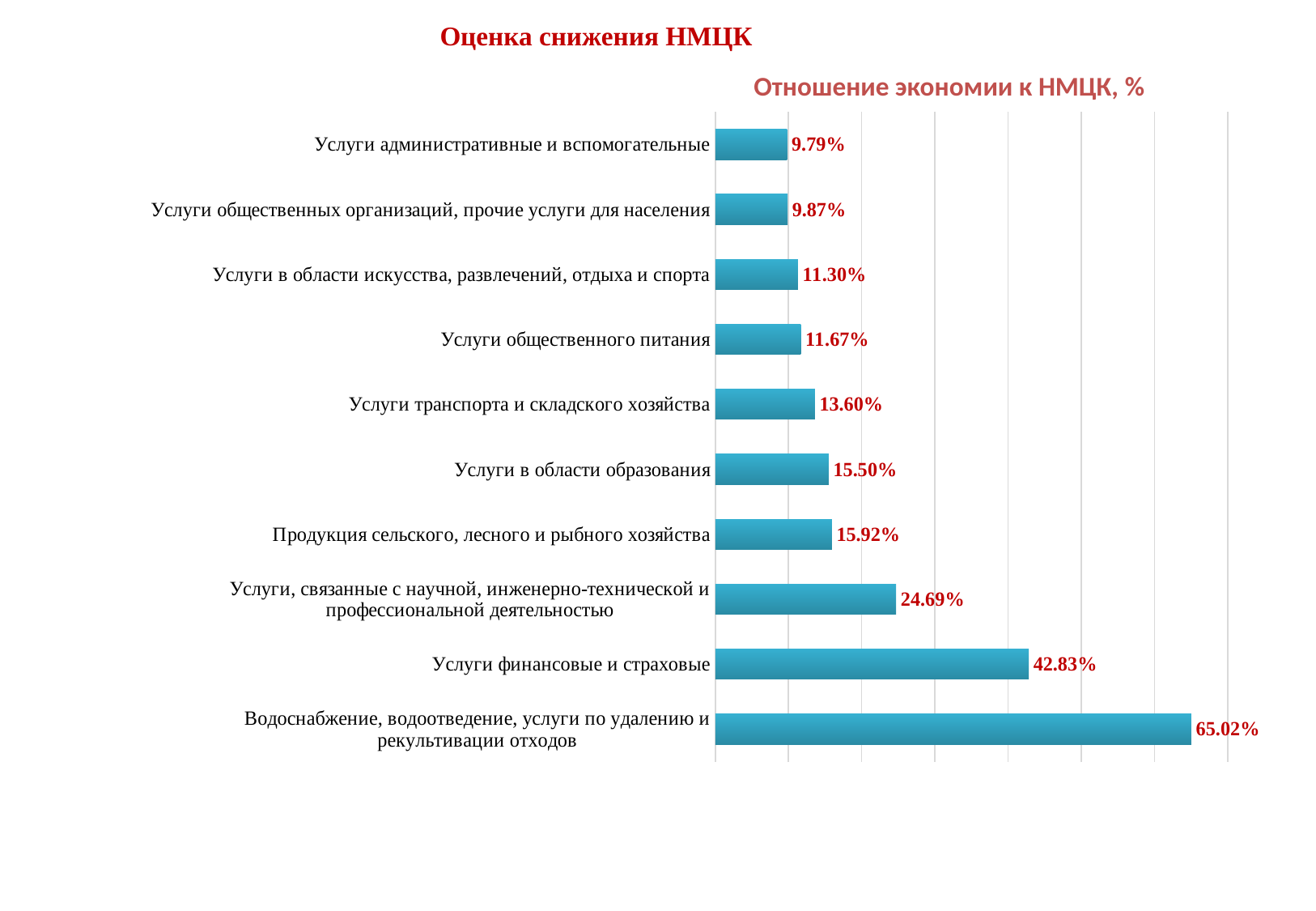
Which is larger: the value for Продукция сельского, лесного и рыбного хозяйства or the value for Услуги в области образования? Продукция сельского, лесного и рыбного хозяйства Which category has the lowest value? Услуги административные и вспомогательные Which category has the highest value? Водоснабжение, водоотведение, услуги по удалению и рекультивации отходов What is the value for Услуги транспорта и складского хозяйства? 13.60% What is the value for Услуги финансовые и страховые? 42.83% What is the value for Услуги общественного питания? 11.67% What is the value for Услуги, связанные с научной, инженерно-технической и профессиональной деятельностью? 24.69% What type of chart is shown on the slide? Bar chart What is the difference between the values for Водоснабжение, водоотведение, услуги по удалению и рекультивации отходов and Услуги финансовые и страховые? 22.19% How many categories are shown in the chart? 10 What is the difference between the values for Услуги в области образования and Услуги транспорта и складского хозяйства? 1.90% What is the title of the chart? Отношение экономии к НМЦК, %